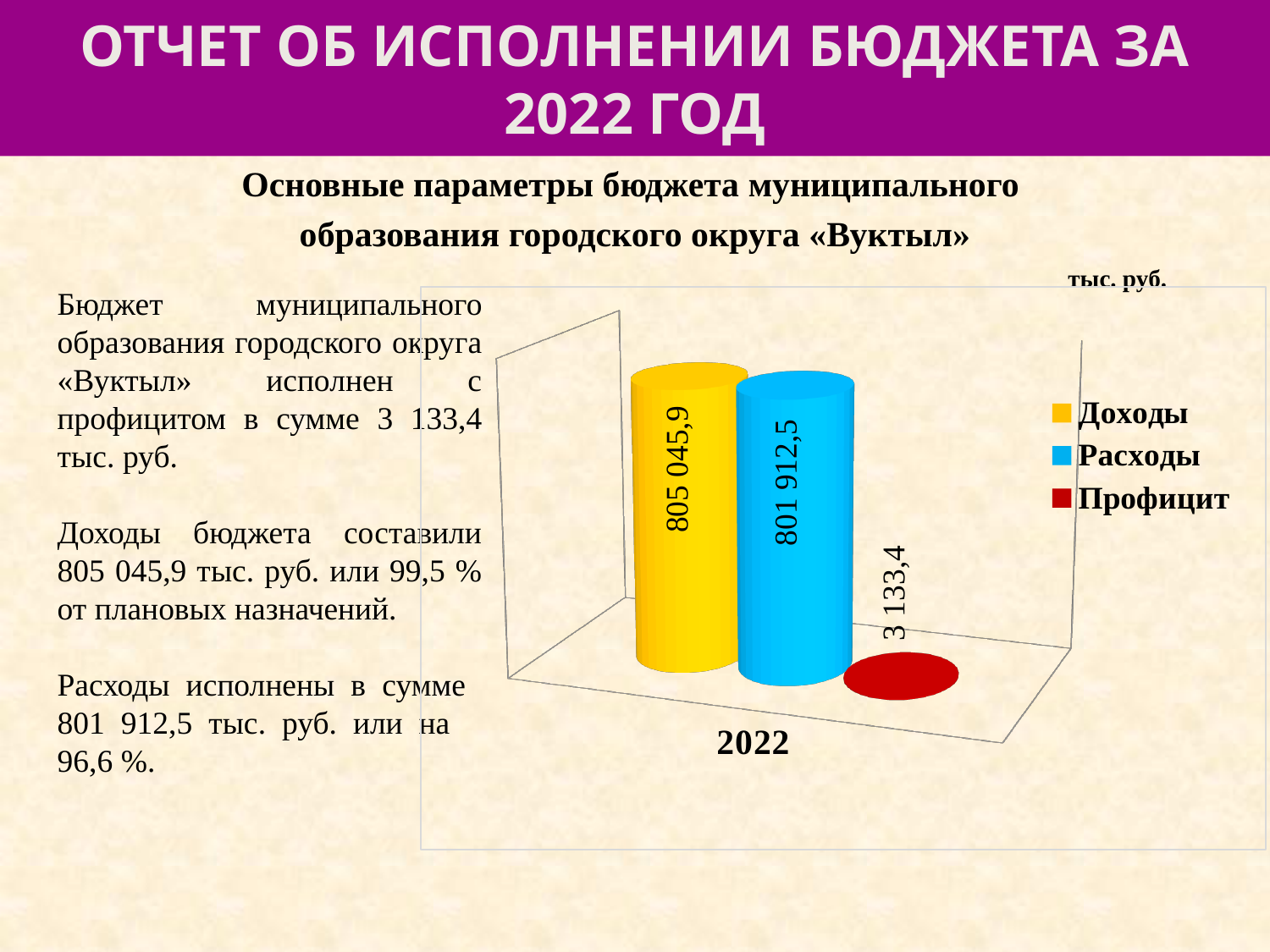
Which series has the highest value in 2022? Доходы What is the value for Профицит in 2022? 3 133,4 What unit is indicated above the chart? тыс. руб. Which is larger in 2022, Расходы or Профицит? Расходы What colour represents Профицит in the chart? Red How many categories are shown on the x axis? 1 What kind of chart is shown on the slide? Bar chart What is the value for Расходы in 2022? 801 912,5 What is the difference between Доходы and Расходы in 2022? 3 133,4 How many series does the legend list? 3 Which series has the lowest value in 2022? Профицит What is the value for Доходы in 2022? 805 045,9